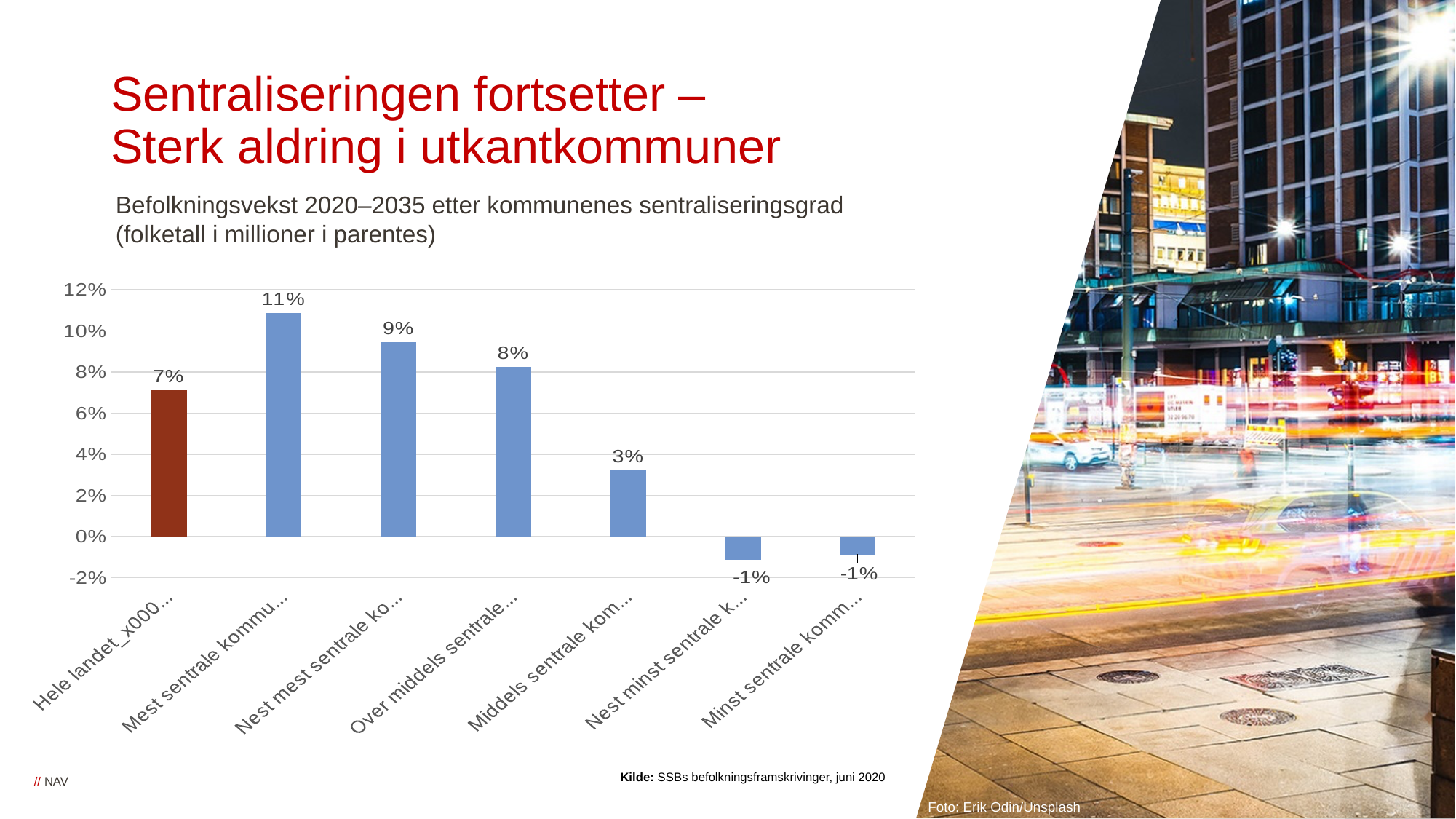
What is the value of the bar labelled "Nest minst sentrale k..."? -1% How many bars are shown in the chart? 7 Do the values rise or fall along the x axis from "Mest sentrale kommu..." to "Minst sentrale komm..."? Fall What is the difference between the value for "Mest sentrale kommu..." and the value for "Hele landet"? 4 percentage points What colour is the bar for "Hele landet", which differs from the other bars? Dark red What is the value of the bar labelled "Mest sentrale kommu..."? 11% What is the value of the bar labelled "Hele landet"? 7% Which is larger: the value for "Nest mest sentrale ko..." or the value for "Over middels sentrale..."? Nest mest sentrale ko... Which category has the highest value in the chart? Mest sentrale kommu... How many bars in the chart have a negative value? 2 What kind of chart is shown on the slide? Bar chart What is the value of the bar labelled "Middels sentrale kom..."? 3%